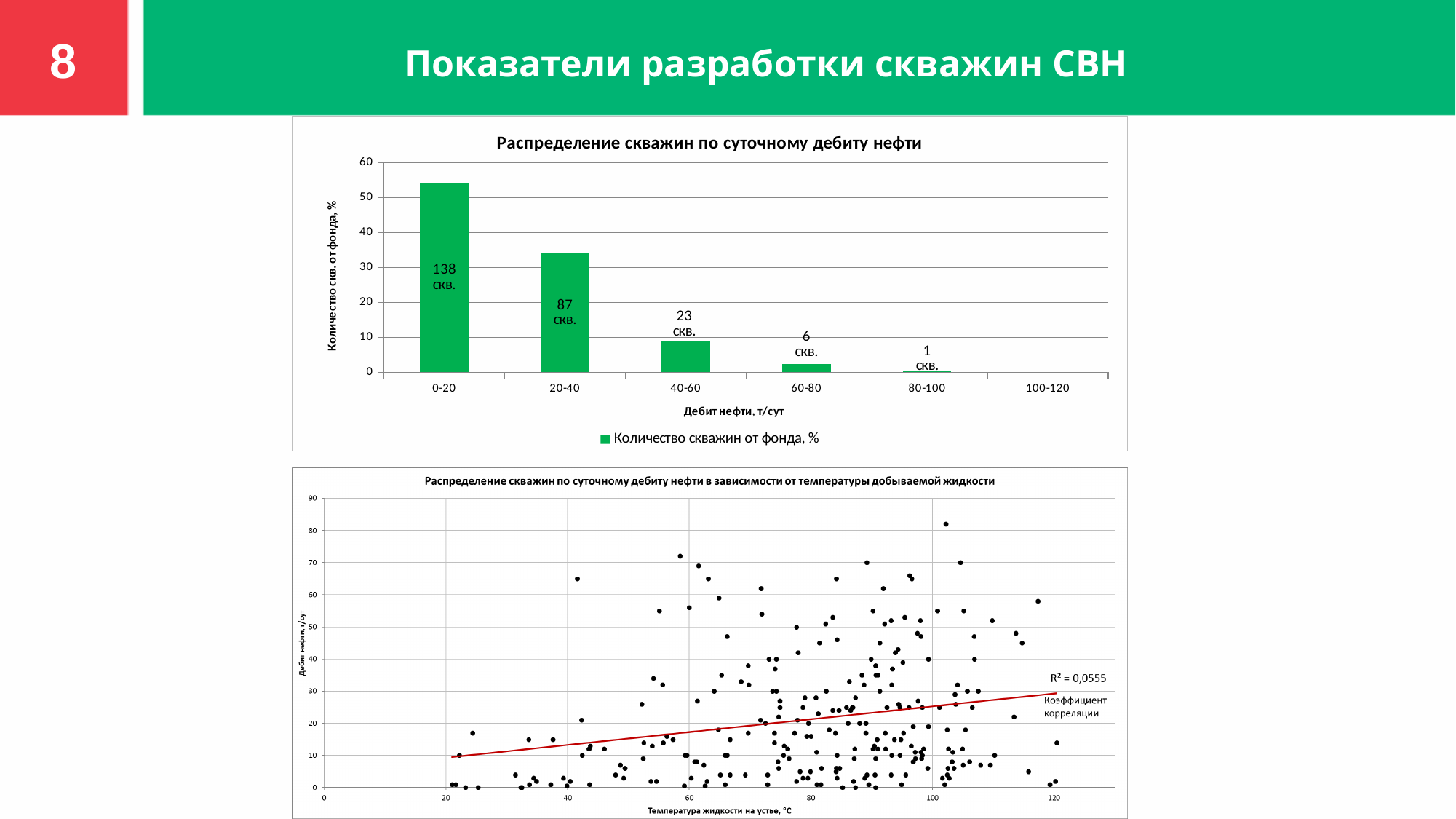
In the top chart, do the bar values rise or fall from left to right along the x axis? fall In the top chart, what data label is shown on the bar for the 20-40 category? 87 скв. In the top chart, what data label is shown on the bar for the 0-20 category? 138 скв. In the top chart, how many categories are shown on the x axis? 6 In the top chart, which category has the highest bar? 0-20 In the bottom chart, what R² value is printed next to the trend line? R² = 0,0555 In the top chart, is the value for the 0-20 category greater or less than 50? greater In the top chart, what data label is shown on the bar for the 80-100 category? 1 скв. In the top chart, what data label is shown on the bar for the 40-60 category? 23 скв. In the top chart, what is the legend entry? Количество скважин от фонда, % In the top chart, is the value for the 20-40 category greater or less than 40? less In the top chart 'Распределение скважин по суточному дебиту нефти', what kind of chart is it? bar chart